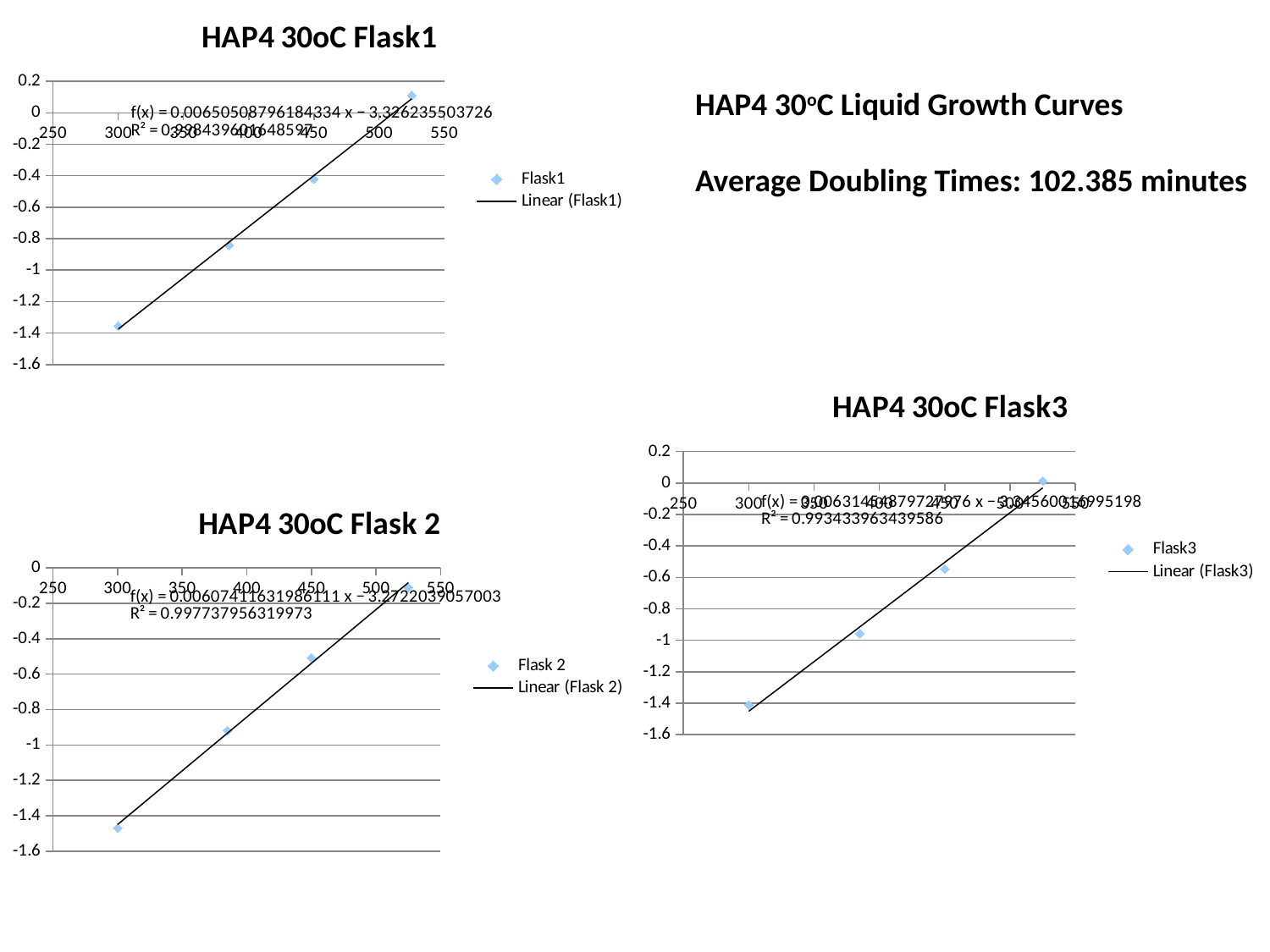
In the HAP4 30oC Flask3 chart, do the values rise or fall as x increases? rise What kind of chart is the HAP4 30oC Flask1 chart? scatter chart In the HAP4 30oC Flask1 chart, how many entries does the legend list? 2 In the HAP4 30oC Flask1 chart, how many data points are plotted? 4 What are the two legend entries in the HAP4 30oC Flask 2 chart? Flask 2 and Linear (Flask 2) In the HAP4 30oC Flask 2 chart, is the value of the rightmost point (near x = 525) greater or less than -0.4? greater In the HAP4 30oC Flask1 chart, is the value of the leftmost point (near x = 300) greater or less than -1.2? less In the HAP4 30oC Flask3 chart, is the value of the point near x = 450 greater or less than -0.4? less In the HAP4 30oC Flask3 chart, what R² value is printed for the trendline? 0.993433963439586 In the HAP4 30oC Flask 2 chart, how many data points are plotted? 4 In the HAP4 30oC Flask1 chart, do the values rise or fall as x increases? rise